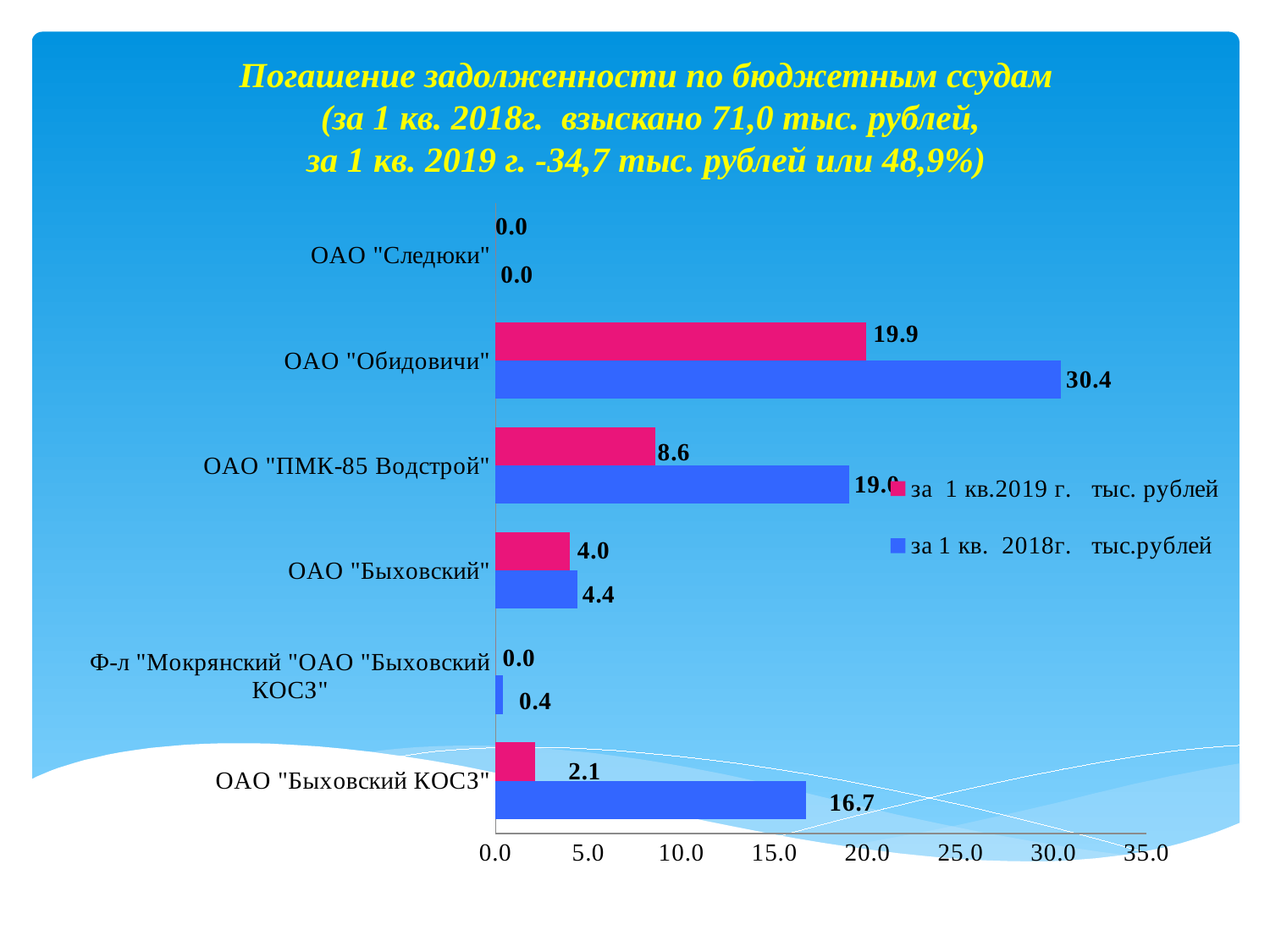
For ОАО "Быховский", which series has the larger value: 2018 or 2019? за 1 кв. 2018г. тыс.рублей What is the difference between the 2018 and 2019 values for ОАО "Обидовичи"? 10.5 What is the difference between the 2018 and 2019 values for ОАО "Быховский КОСЗ"? 14.6 Which category has the highest value in the series "за 1 кв. 2018г. тыс.рублей"? ОАО "Обидовичи" What is the value for ОАО "Быховский КОСЗ" in the series "за 1 кв. 2018г. тыс.рублей"? 16.7 What is the value for ОАО "Обидовичи" in the series "за 1 кв.2019 г. тыс. рублей"? 19.9 What is the value for Ф-л "Мокрянский "ОАО "Быховский КОСЗ" in the series "за 1 кв. 2018г. тыс.рублей"? 0.4 What is the value for ОАО "Обидовичи" in the series "за 1 кв. 2018г. тыс.рублей"? 30.4 How many series does the legend list? 2 How many categories are shown on the chart? 6 What is the value for ОАО "ПМК-85 Водстрой" in the series "за 1 кв.2019 г. тыс. рублей"? 8.6 Is the 2018 value for ОАО "ПМК-85 Водстрой" greater or less than 15.0? greater